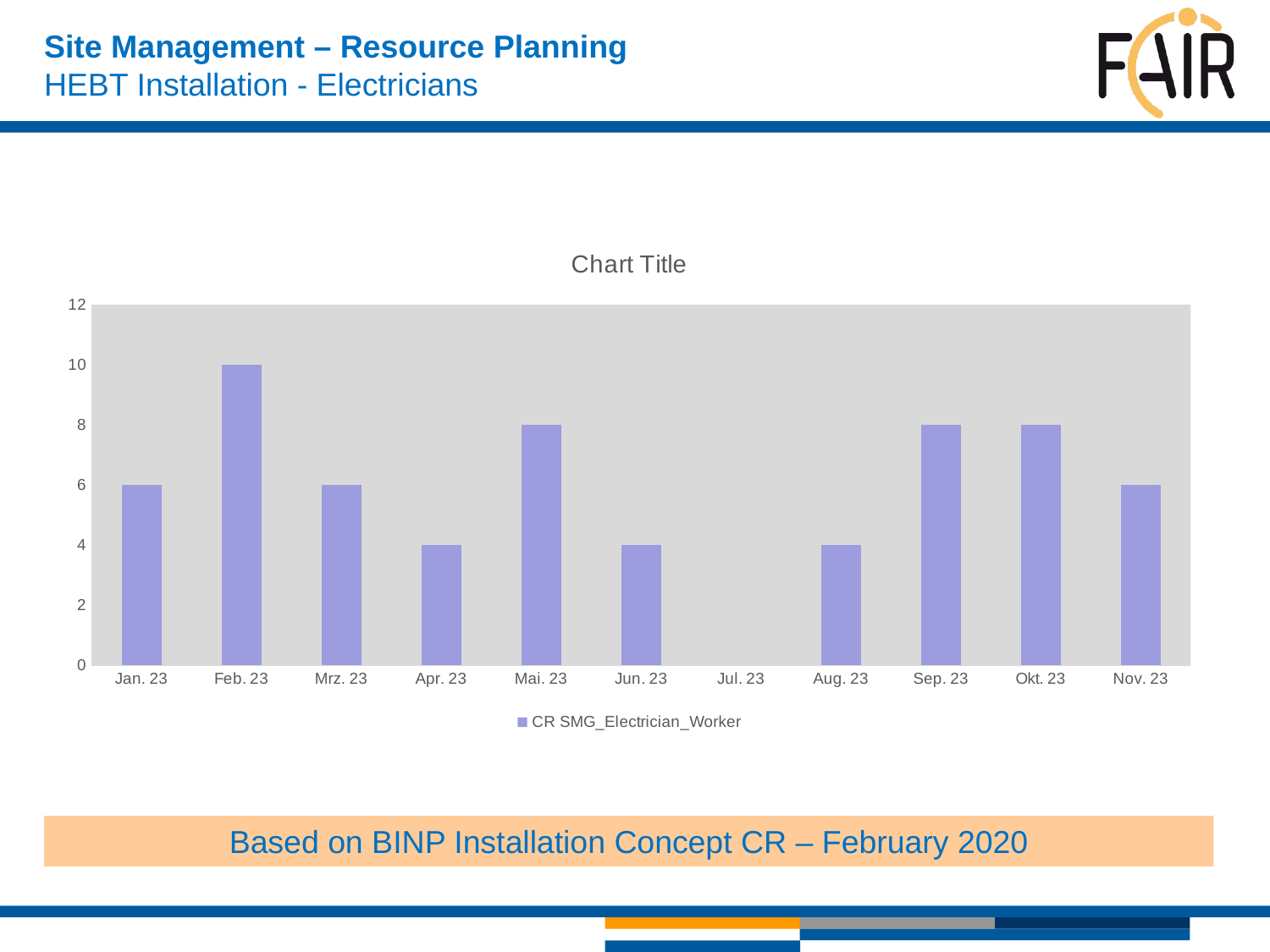
What is the value for Feb. 23? 10 What is the value for Apr. 23? 4 What type of chart is shown on the slide? bar chart How many series does the legend list? 1 Which month has no bar (a value of 0)? Jul. 23 Is the value for Okt. 23 greater or less than 6? greater How many months are shown on the x axis? 11 Which is larger, the value for Sep. 23 or the value for Aug. 23? Sep. 23 What is the value for Mai. 23? 8 What is the difference between the values for Feb. 23 and Jan. 23? 4 What is the name of the series shown in the legend? CR SMG_Electrician_Worker Which month has the highest value? Feb. 23